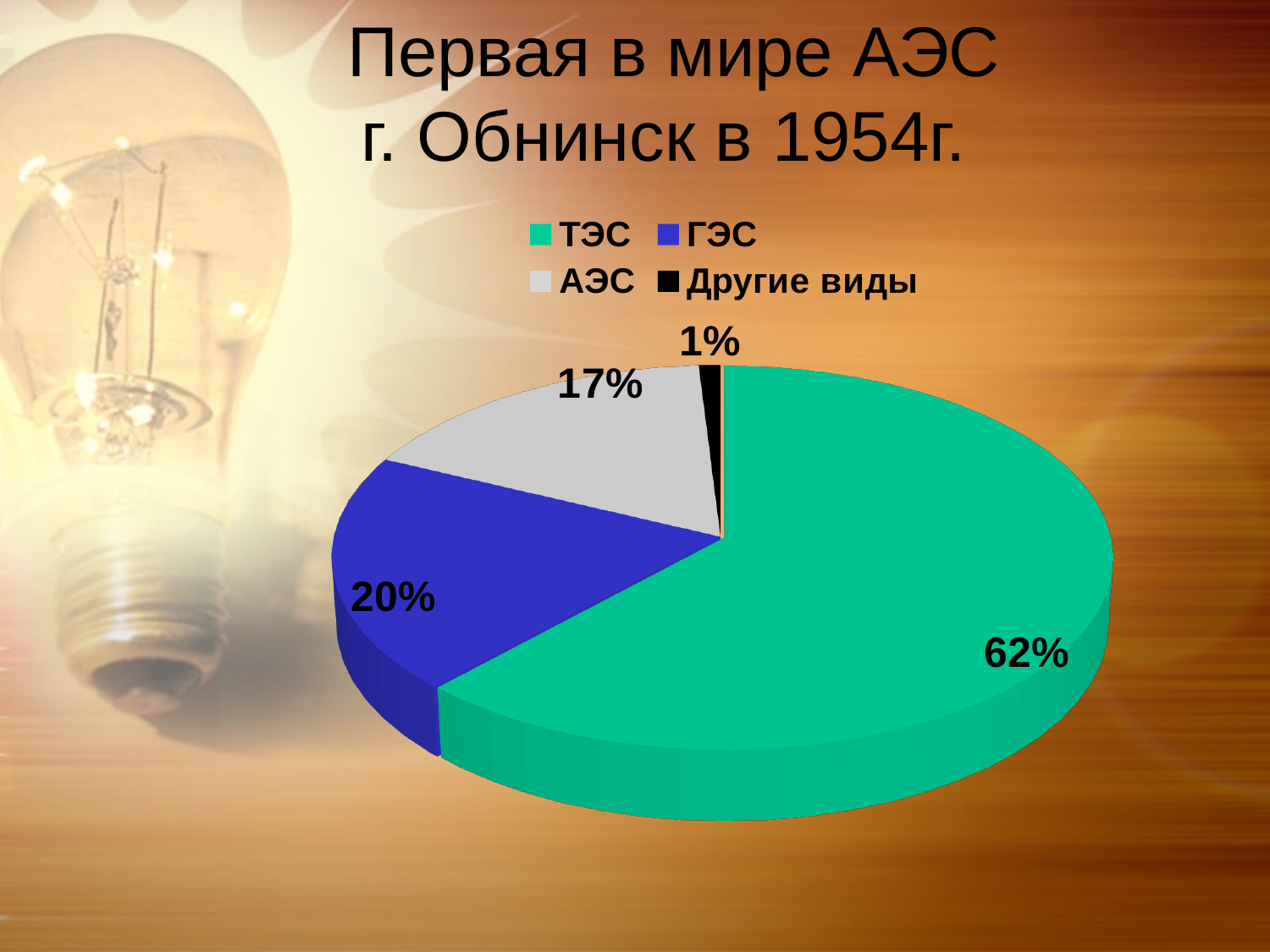
Which is larger, the share of ГЭС or the share of АЭС? ГЭС Which category has the smallest slice of the pie? Другие виды What kind of chart is shown on the slide? pie chart What colour is the slice for АЭС? light grey Which category has the largest slice of the pie? ТЭС What share of the pie does ТЭС have? 62% What is the difference between the shares of ТЭС and ГЭС? 42% What share of the pie does АЭС have? 17% How many categories does the legend list? 4 What share of the pie does Другие виды have? 1% What is the difference between the shares of ГЭС and АЭС? 3% What share of the pie does ГЭС have? 20%